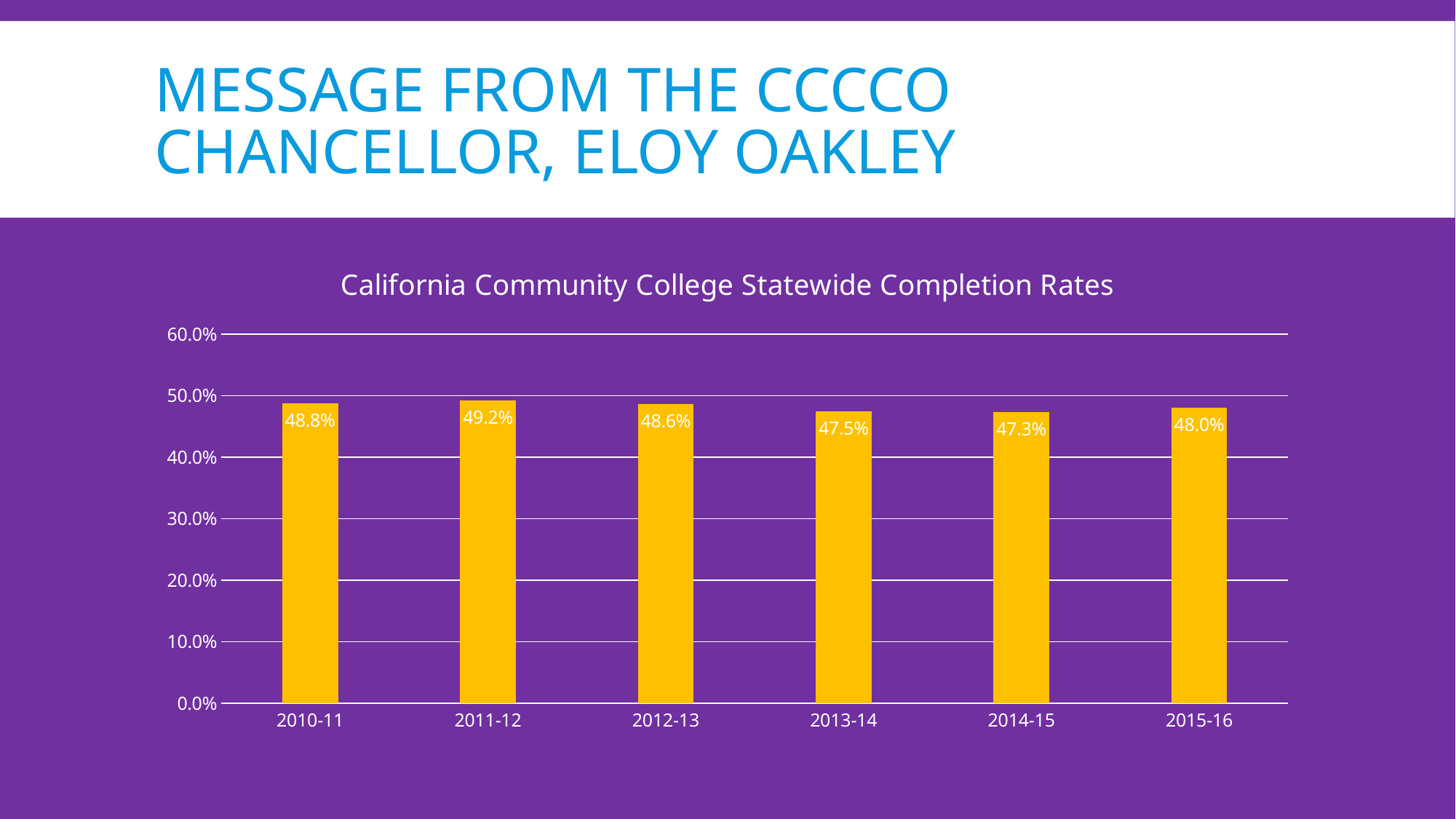
What is the completion rate for 2010-11? 48.8% What is the completion rate for 2015-16? 48.0% What is the difference between the completion rates for 2011-12 and 2014-15? 1.9% Which year has the highest completion rate? 2011-12 Is the completion rate for 2011-12 greater or less than 50.0%? less What is the completion rate for 2013-14? 47.5% Which year has the lowest completion rate? 2014-15 How many years are shown on the x axis? 6 What kind of chart is shown on the slide? bar chart Does the completion rate rise or fall from 2011-12 to 2014-15? fall What is the title of the chart? California Community College Statewide Completion Rates Which is larger, the completion rate for 2012-13 or for 2015-16? 2012-13